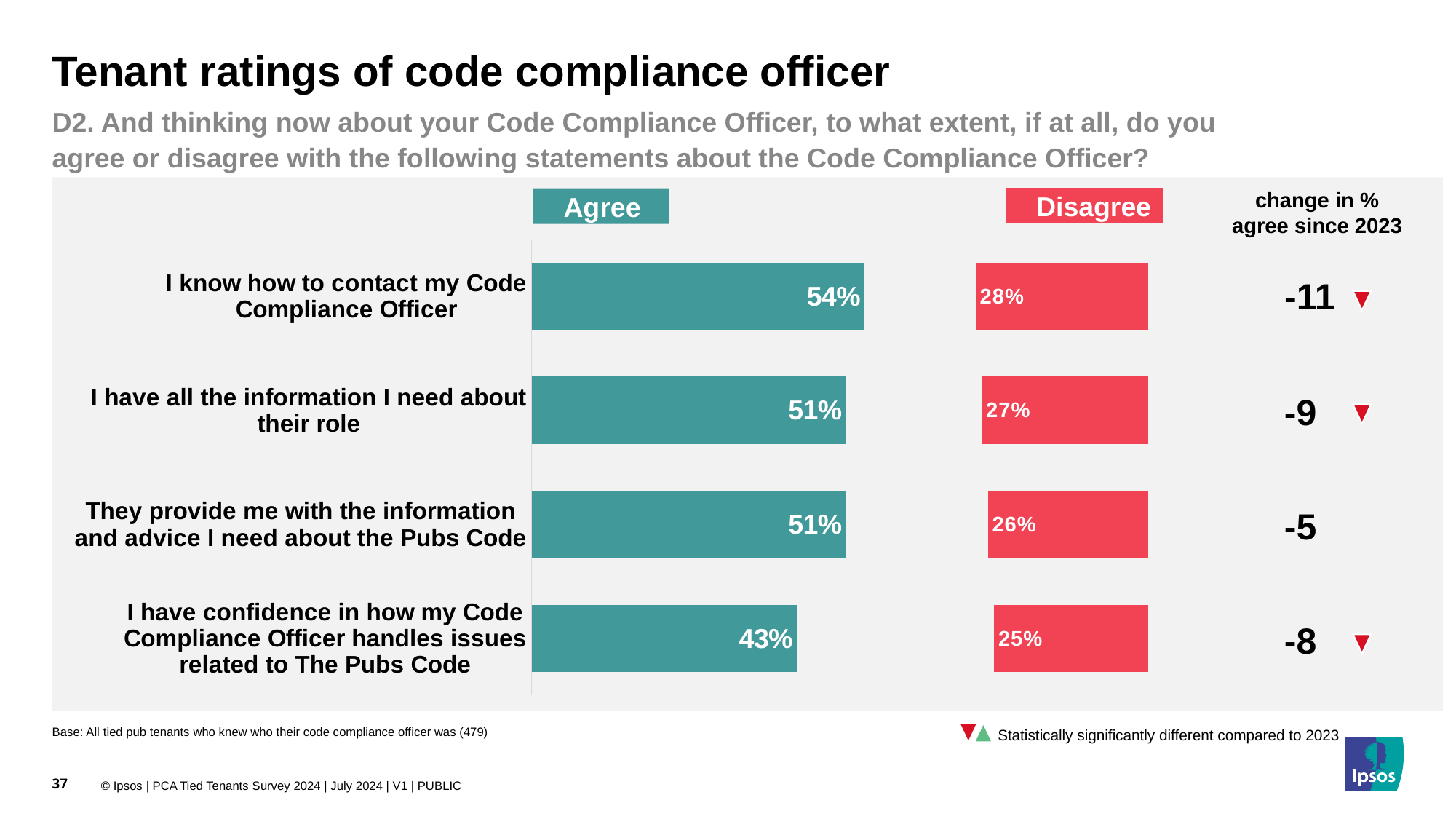
What is the change in % agree since 2023 for "I know how to contact my Code Compliance Officer"? -11 Which colour represents the Disagree responses in the chart? Red What percentage of tenants agree with the statement "I have all the information I need about their role"? 51% How many statements are shown in the chart? 4 What percentage of tenants disagree with the statement "I have confidence in how my Code Compliance Officer handles issues related to The Pubs Code"? 25% Which is larger: the Disagree percentage for "I know how to contact my Code Compliance Officer" or the Disagree percentage for "I have confidence in how my Code Compliance Officer handles issues related to The Pubs Code"? I know how to contact my Code Compliance Officer (28%) What is the difference between the Agree percentage and the Disagree percentage for "They provide me with the information and advice I need about the Pubs Code"? 25 percentage points What percentage of tenants agree with the statement "I know how to contact my Code Compliance Officer"? 54% Which statement has the highest percentage of tenants agreeing? I know how to contact my Code Compliance Officer What kind of chart is shown on the slide? Bar chart Which statement has the lowest percentage of tenants agreeing? I have confidence in how my Code Compliance Officer handles issues related to The Pubs Code How many response series does the chart show? 2 (Agree and Disagree)